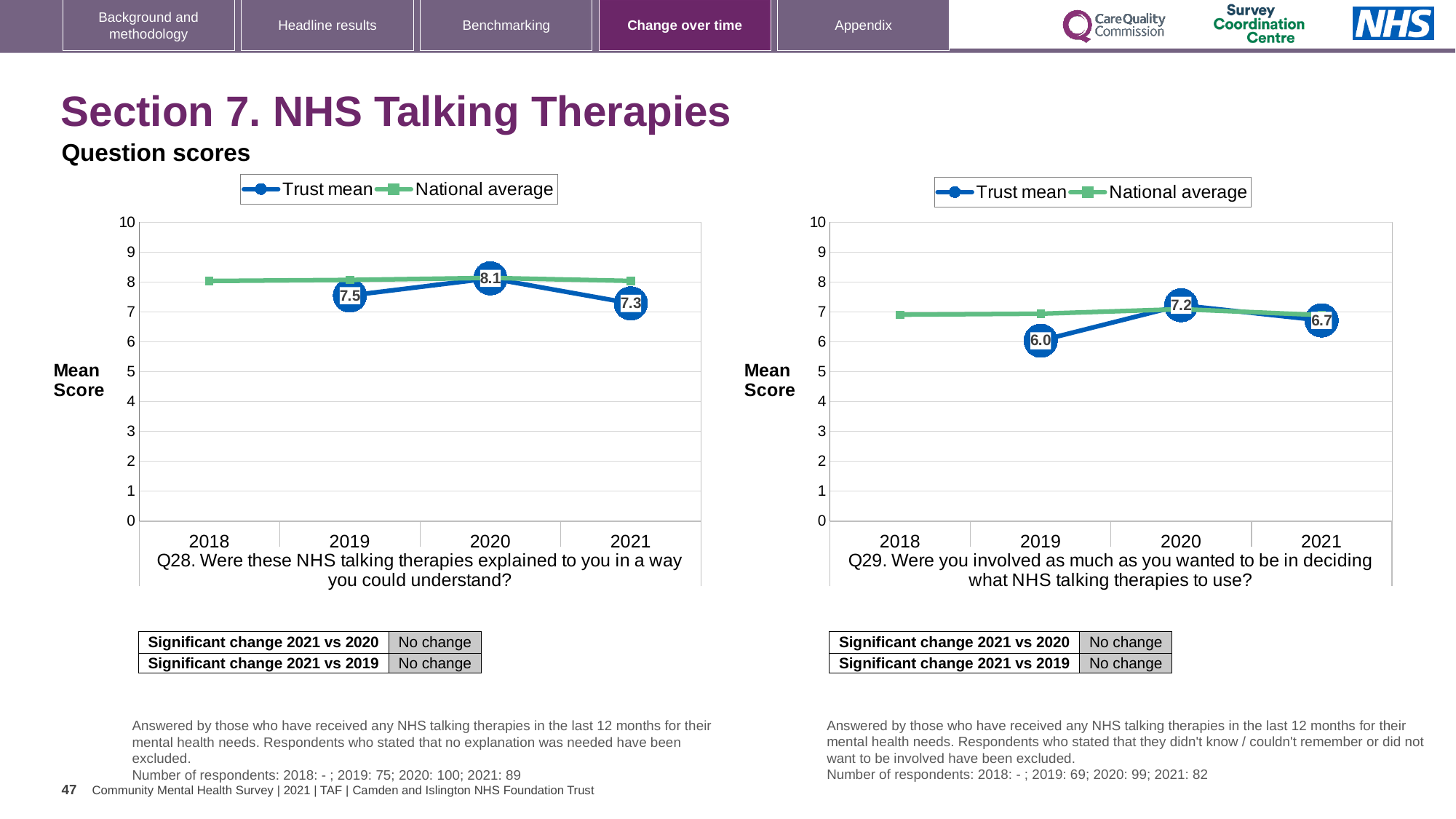
In the Q28 chart on the left, which year has the lowest labelled Trust mean score? 2021 In the Q29 chart on the right, which year has the highest Trust mean score? 2020 In the Q28 chart on the left, is the Trust mean score for 2019 higher or lower than for 2020? lower In the Q28 chart on the left, what is the Trust mean score for 2021? 7.3 In the Q29 chart on the right, what is the difference between the Trust mean scores for 2020 and 2019? 1.2 In the Q28 chart on the left, what is the Trust mean score for 2020? 8.1 How many years are shown on the x axis of the Q28 chart on the left? 4 In the Q29 chart on the right, what is the Trust mean score for 2019? 6.0 In the Q29 chart on the right, is the National average value for 2018 greater or less than 5? greater What type of chart is used for Q28 on the left? Line chart In the Q29 chart on the right, does the Trust mean rise or fall from 2020 to 2021? fall How many series does the legend of the Q29 chart on the right list? 2